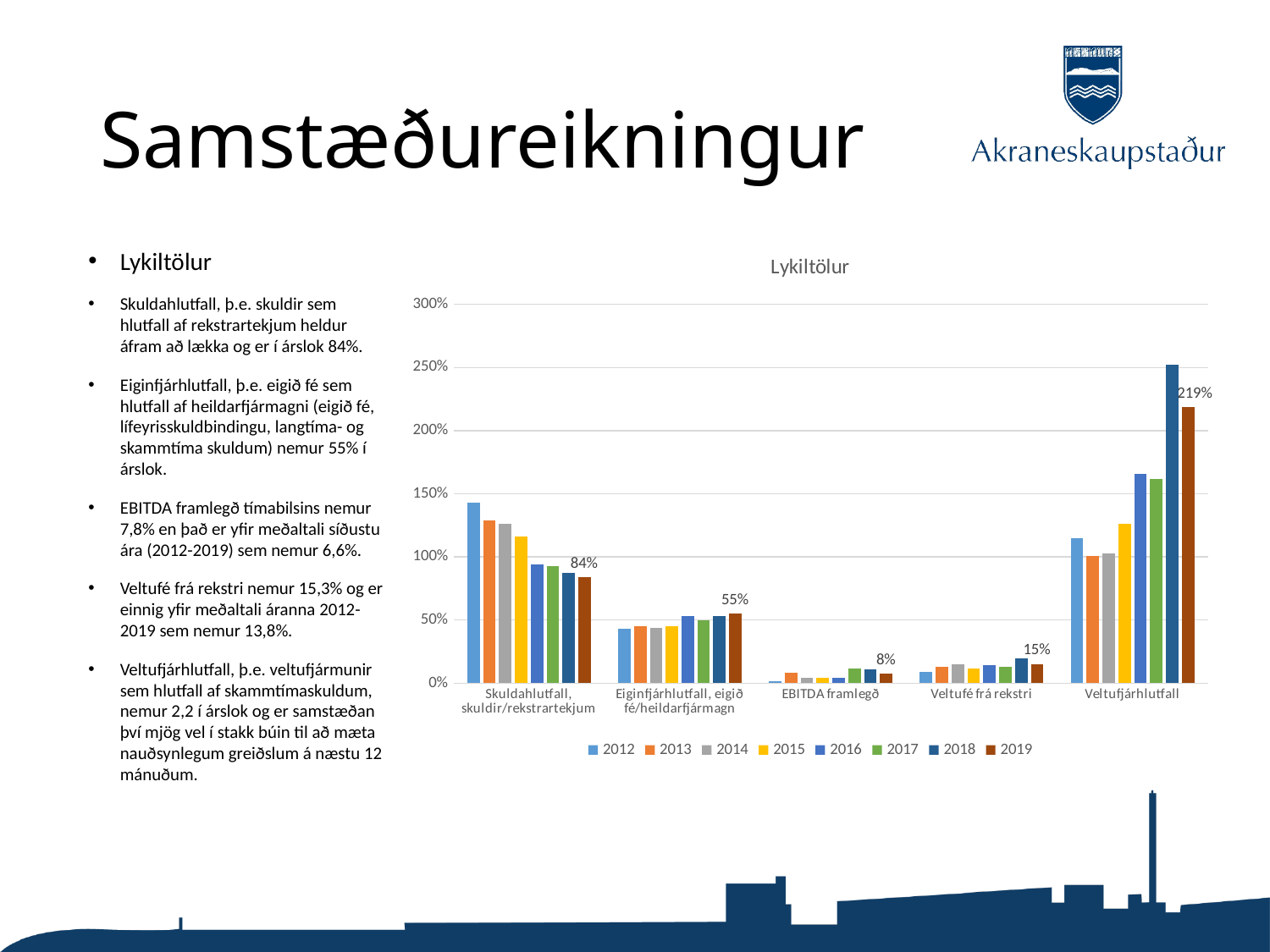
What is the 2019 value for Skuldahlutfall, skuldir/rekstrartekjum? 84% Is the 2012 value for Skuldahlutfall, skuldir/rekstrartekjum greater or less than 100%? greater What type of chart is shown on the slide? bar chart Which category has the lowest 2019 value? EBITDA framlegð Do the bars for Skuldahlutfall, skuldir/rekstrartekjum rise or fall from 2012 to 2019? fall What is the 2019 value for EBITDA framlegð? 8% What is the title of the chart? Lykiltölur What is the difference between the 2019 values for Veltufjárhlutfall and Skuldahlutfall, skuldir/rekstrartekjum? 135% How many series does the chart legend list? 8 What is the 2019 value for Veltufjárhlutfall? 219% How many categories are shown on the x axis of the chart? 5 What is the 2019 value for Eiginfjárhlutfall, eigið fé/heildarfjármagn? 55%